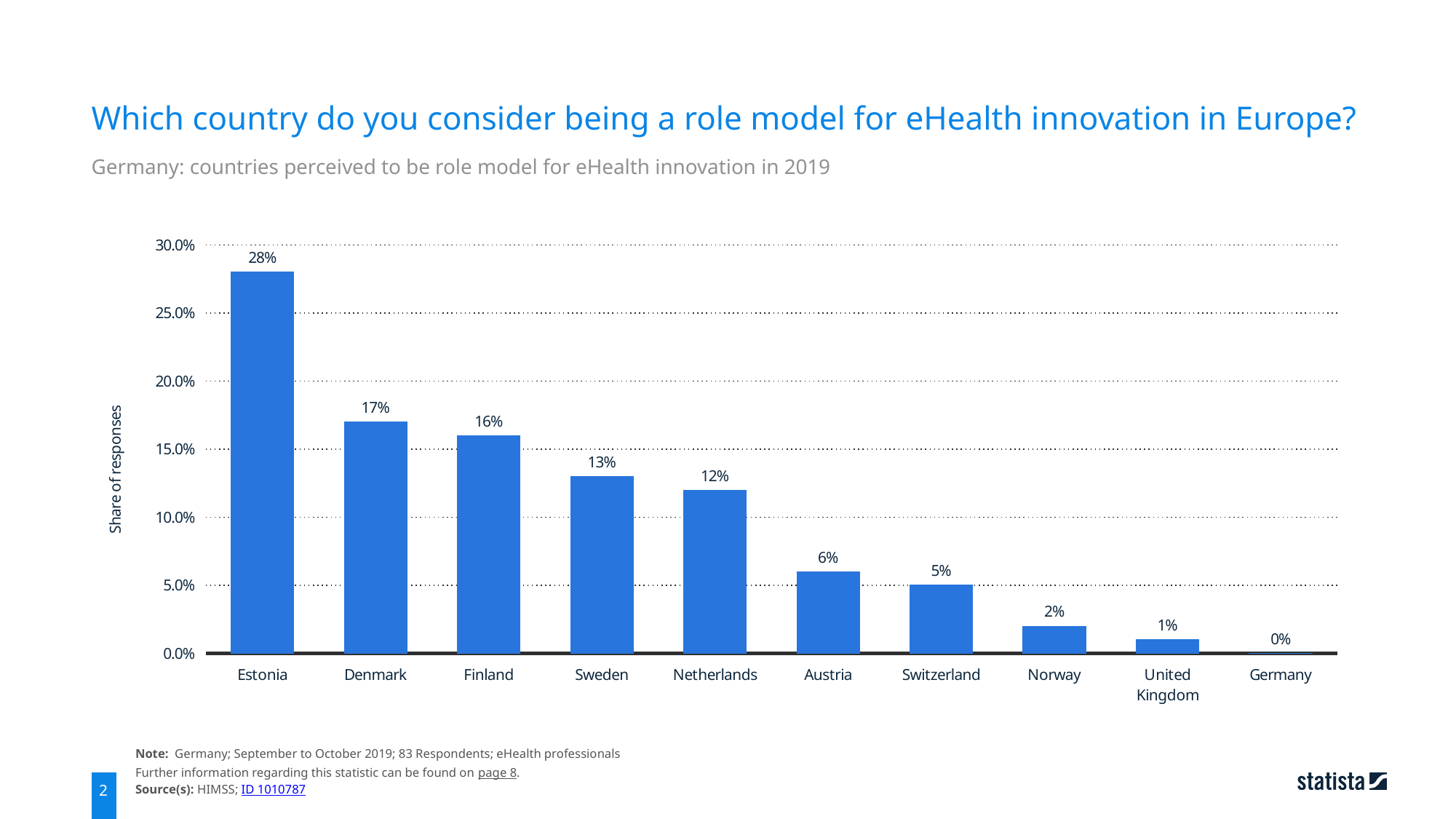
How many countries are shown on the x axis? 10 What is the value shown for the Netherlands? 12% Which country has the lowest share of responses? Germany What is the label of the y axis? Share of responses What is the difference between the shares for Estonia and Denmark? 11% Which has a larger share of responses, Finland or Sweden? Finland Is the value for Denmark greater or less than 15.0%? greater What kind of chart is shown on the slide? Bar chart Which country has the highest share of responses? Estonia What share of responses named Estonia as a role model for eHealth innovation? 28% What is the difference between the shares for Sweden and Austria? 7% What share of responses is shown for the United Kingdom? 1%